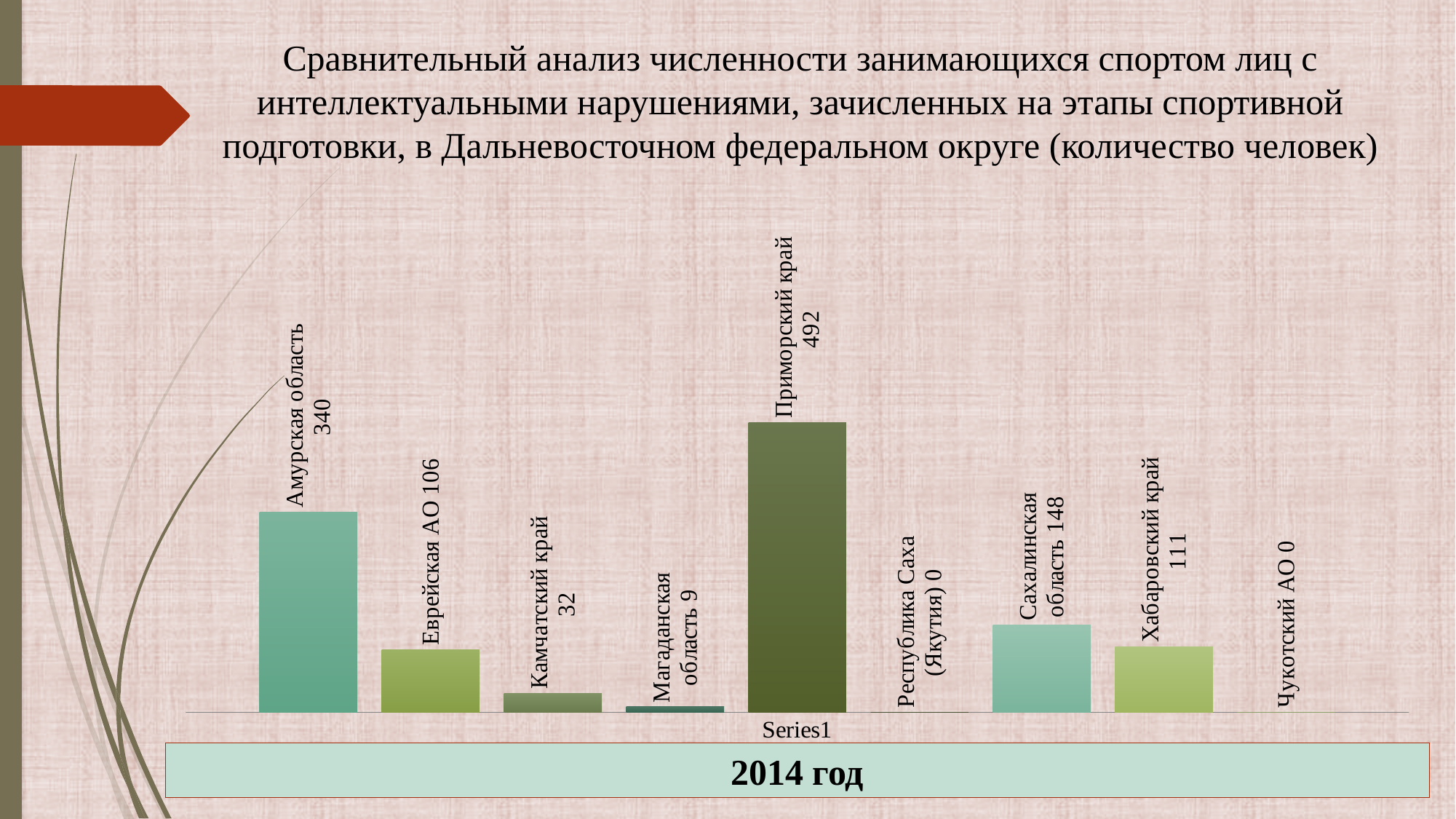
Which year does the chart refer to, according to the label below the chart? 2014 год What is the value for Магаданская область? 9 What is the difference between the values for Приморский край and Амурская область? 152 Which is larger, the value for Еврейская АО or the value for Хабаровский край? Хабаровский край Which region has the highest value? Приморский край What kind of chart is shown on the slide? bar chart What is the value for Амурская область? 340 What is the value for Приморский край? 492 What is the difference between the values for Сахалинская область and Хабаровский край? 37 How many regions (bars) are shown in the chart? 9 What is the value for Сахалинская область? 148 Which regions have a value of 0? Республика Саха (Якутия) and Чукотский АО